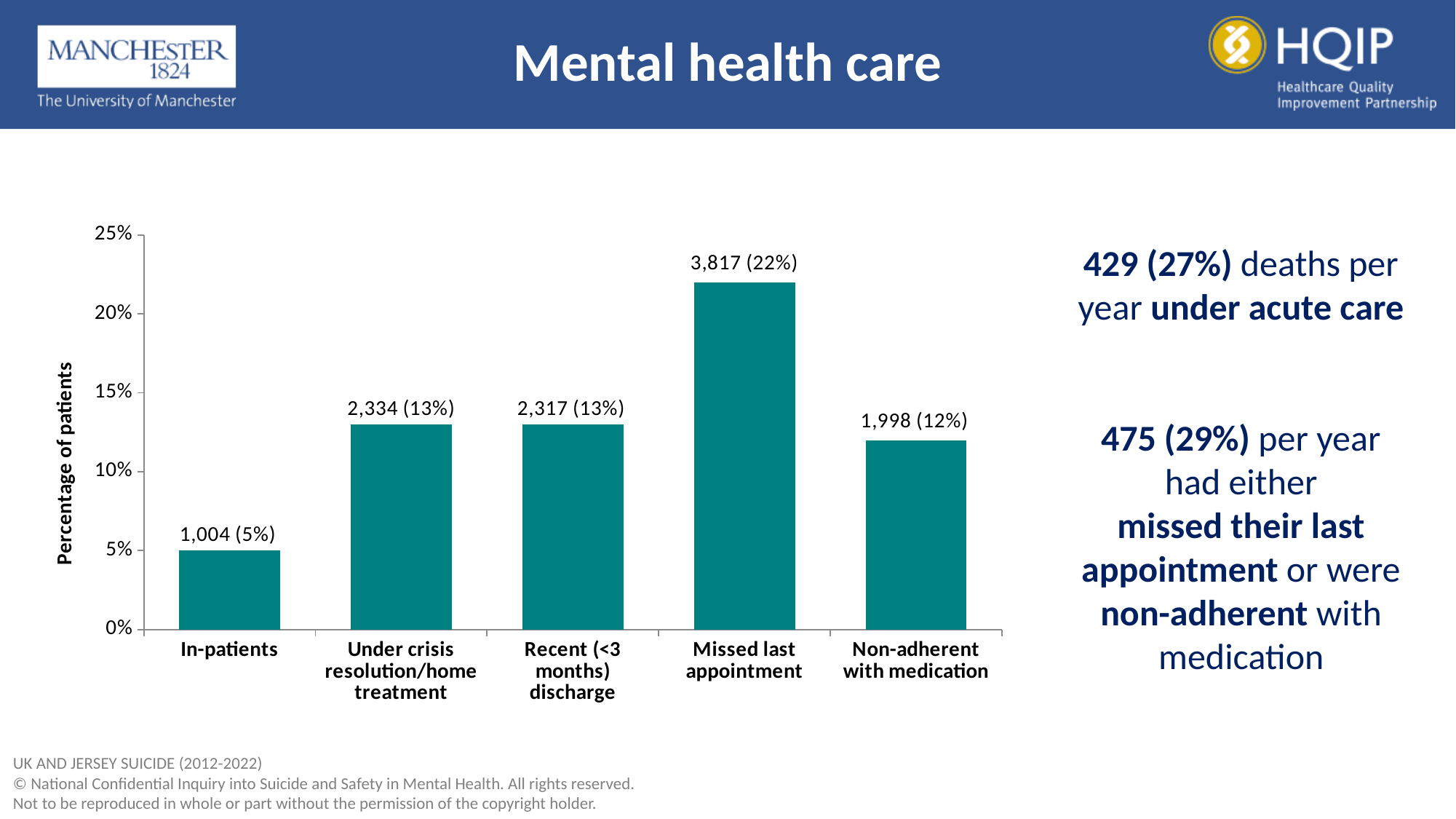
What is the data label shown for the Non-adherent with medication bar? 1,998 (12%) What is the data label shown for the Missed last appointment bar? 3,817 (22%) What is the data label shown for the In-patients bar? 1,004 (5%) What is the data label shown for the Under crisis resolution/home treatment bar? 2,334 (13%) What is the label of the vertical axis of the chart? Percentage of patients Which category has the highest percentage of patients? Missed last appointment Is the value for Missed last appointment greater or less than 20%? greater What kind of chart is shown on the slide? Bar chart Which is larger: the number of patients for Under crisis resolution/home treatment or for Recent (<3 months) discharge? Under crisis resolution/home treatment Which category has the lowest percentage of patients? In-patients How many categories are shown on the x axis of the chart? 5 What is the difference in percentage points between Missed last appointment and In-patients? 17%